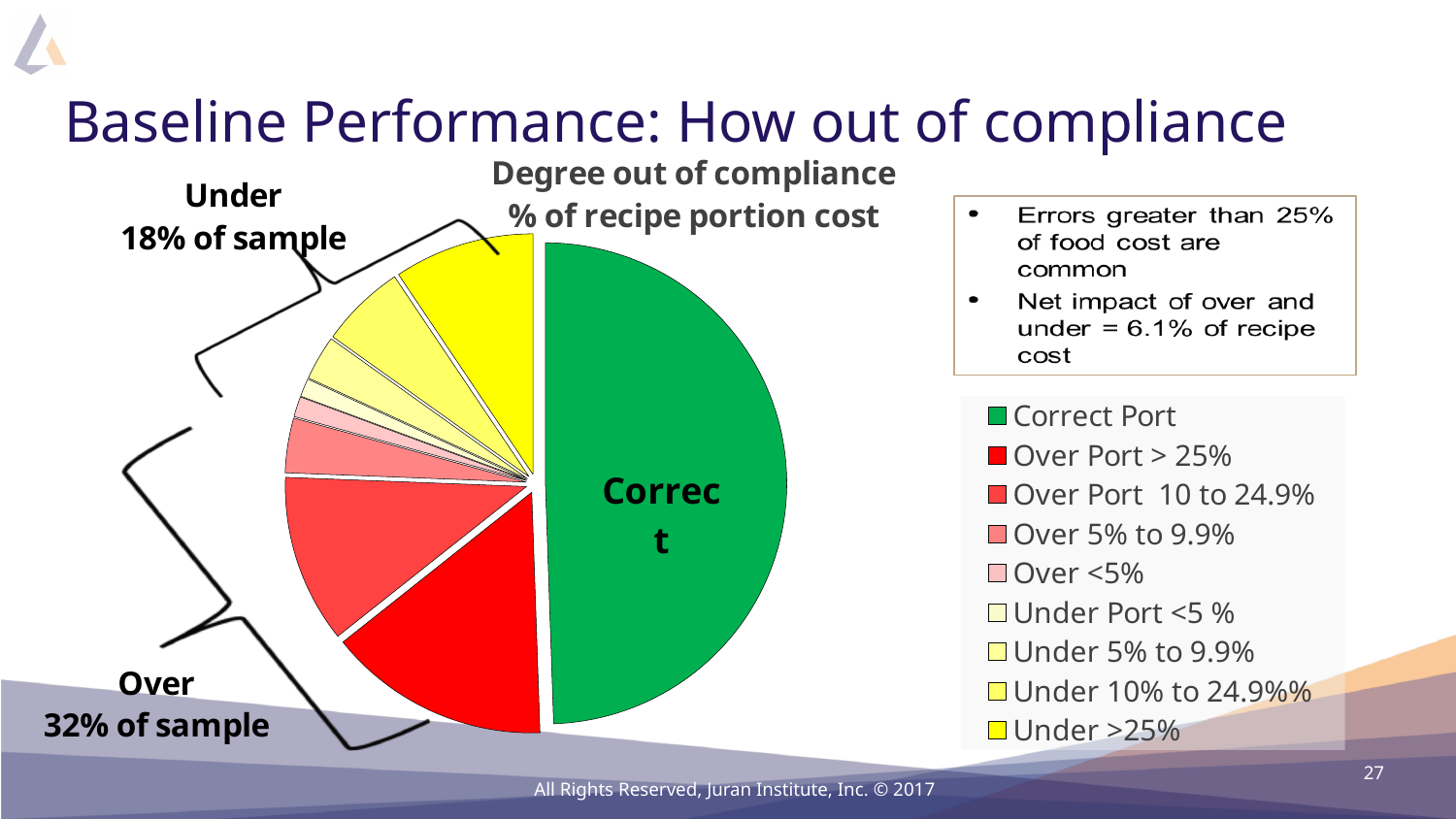
What colour is the 'Correct Port' slice in the pie chart? green Which category has the largest slice of the pie chart? Correct Port According to the annotation, what share of the sample is 'Over'? 32% of sample What kind of chart is shown on the slide? pie chart According to the annotation, what share of the sample is 'Under'? 18% of sample What is the difference in percentage points between the 'Over' share (32%) and the 'Under' share (18%) of the sample? 14 Which slice is larger, 'Correct Port' or 'Over Port > 25%'? Correct Port Which slice is larger, 'Over Port > 25%' or 'Over <5%'? Over Port > 25% Which slice is larger, 'Under >25%' or 'Under Port <5 %'? Under >25% How many categories does the legend of the pie chart list? 9 What is the title of the pie chart? Degree out of compliance % of recipe portion cost